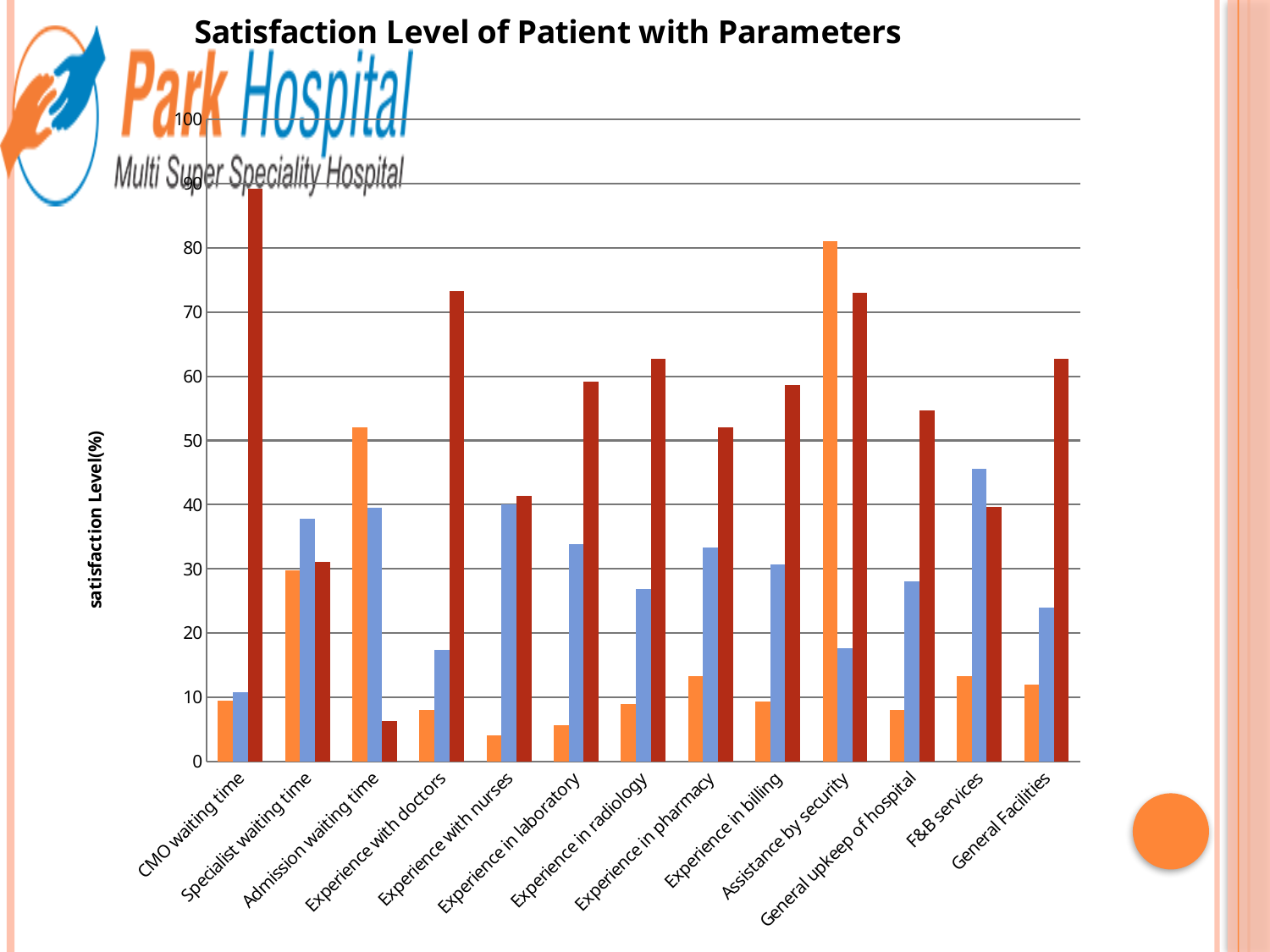
What is the title of the chart? Satisfaction Level of Patient with Parameters Is the orange bar for Assistance by security greater or less than 80? greater Which category has the shortest orange bar? Experience with nurses Which category has the tallest orange bar? Assistance by security What is the label on the vertical axis of the chart? satisfaction Level(%) Is the dark red bar for CMO waiting time greater or less than 80? greater Is the orange bar for Experience with nurses greater or less than 10? less What kind of chart is shown on the slide? bar chart Which category has the tallest dark red bar? CMO waiting time For F&B services, which is taller: the blue bar or the dark red bar? the blue bar How many categories are shown along the x axis of the chart? 13